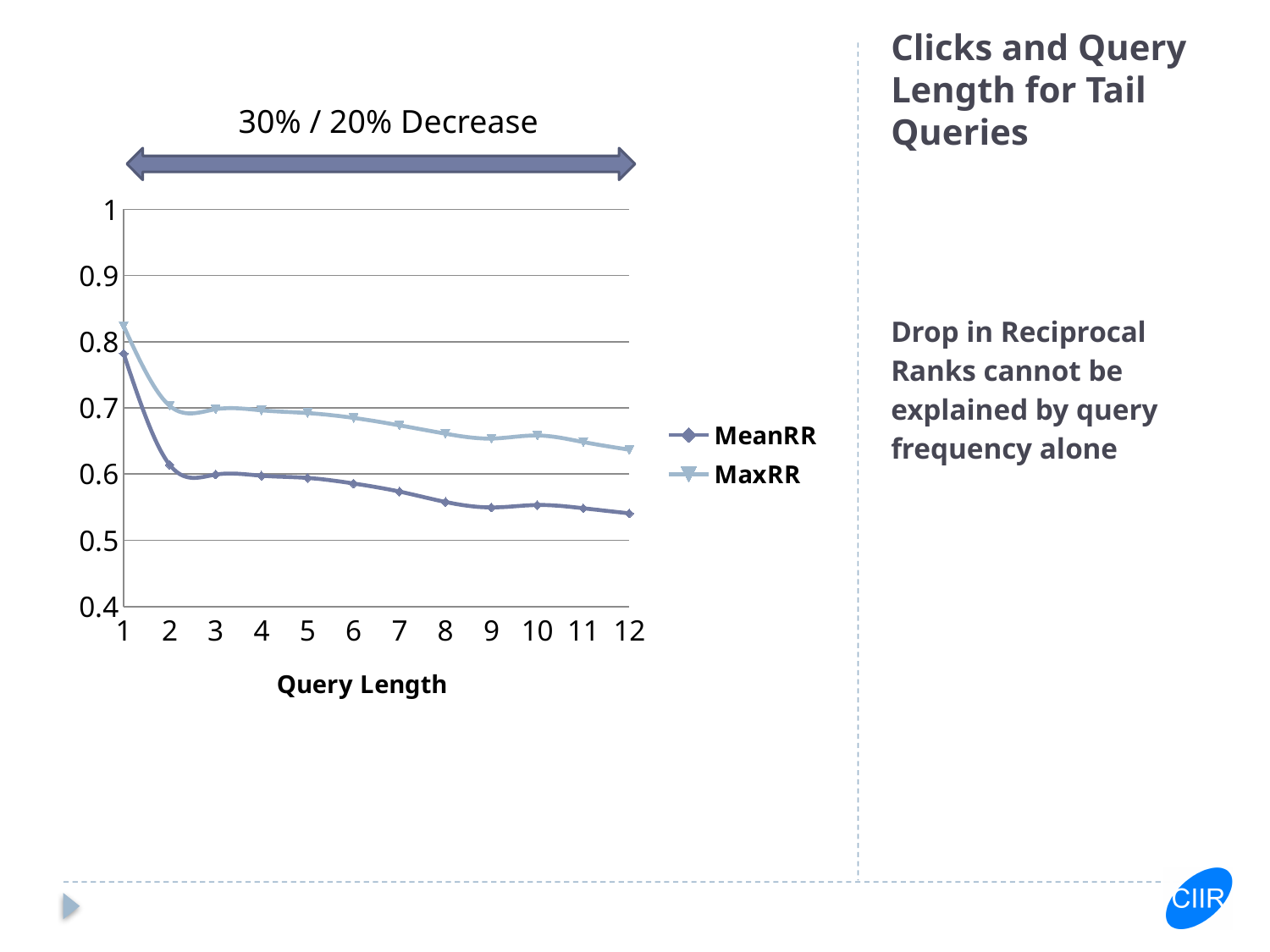
Do the MeanRR values rise or fall as query length increases from 1 to 12? fall Is the MeanRR value at query length 9 greater or less than 0.6? less At which query length is the MeanRR value highest? 1 What is the title of the chart's x axis? Query Length Is the MaxRR value at query length 12 greater or less than 0.6? greater At which query length is the MaxRR value highest? 1 What kind of chart is shown on the slide? line chart At query length 12, which series has the larger value, MeanRR or MaxRR? MaxRR Do the MaxRR values rise or fall as query length increases from 1 to 12? fall How many series does the chart's legend list? 2 Is the MaxRR value at query length 1 greater or less than 0.8? greater How many query length values are plotted along the x axis? 12